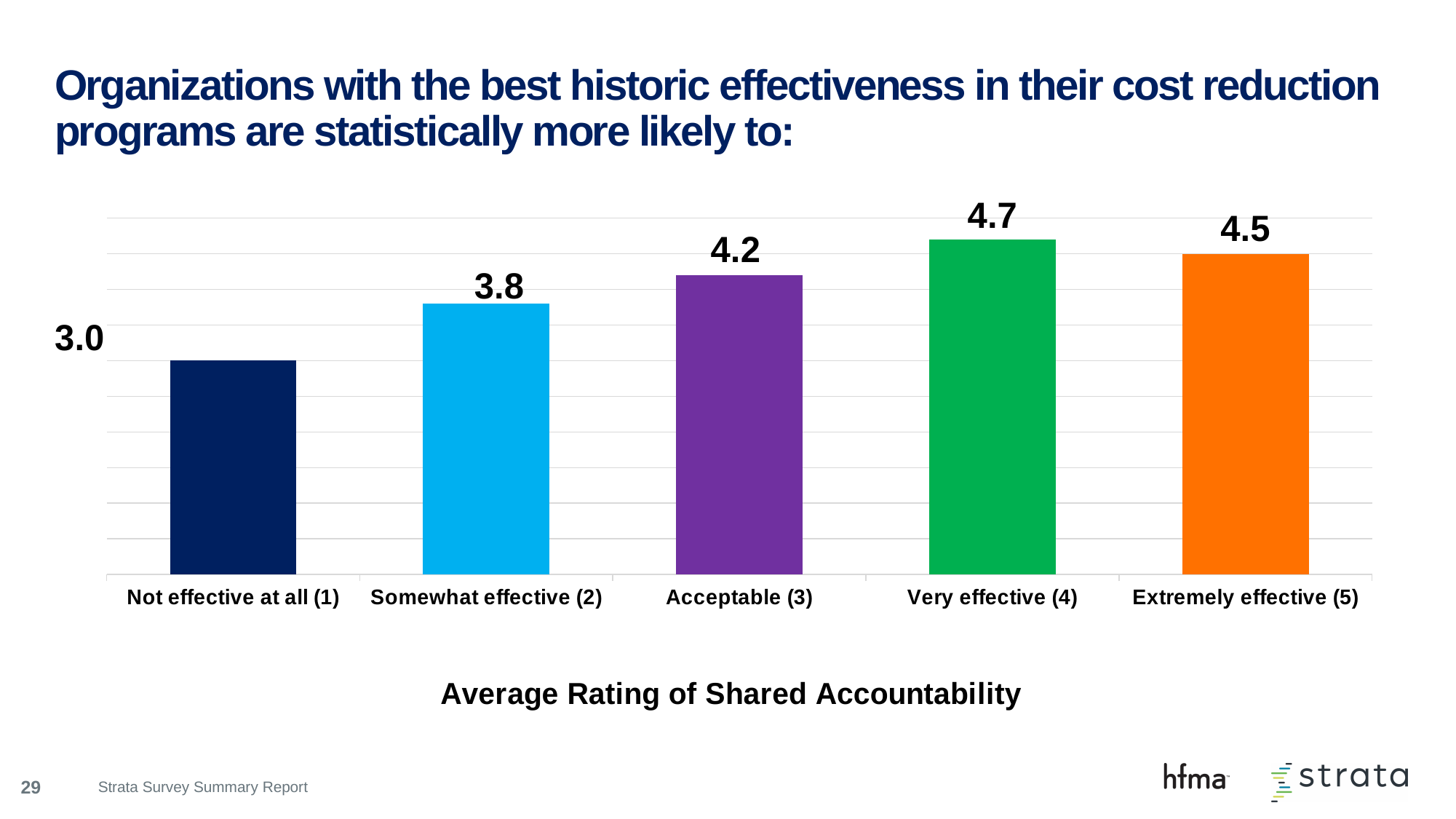
Which category has the highest average rating of shared accountability? Very effective (4) What is the value shown for Extremely effective (5)? 4.5 What is the difference between the values for Somewhat effective (2) and Acceptable (3)? 0.4 What is the value shown for Not effective at all (1)? 3.0 What is the difference between the values for Very effective (4) and Not effective at all (1)? 1.7 What kind of chart is shown on the slide? Bar chart Which is larger, the value for Very effective (4) or Extremely effective (5)? Very effective (4) How many categories are shown on the chart? 5 What is the title shown below the chart? Average Rating of Shared Accountability Do the values rise or fall from Not effective at all (1) to Very effective (4)? Rise What is the average rating of shared accountability for Acceptable (3)? 4.2 Which category has the lowest average rating of shared accountability? Not effective at all (1)